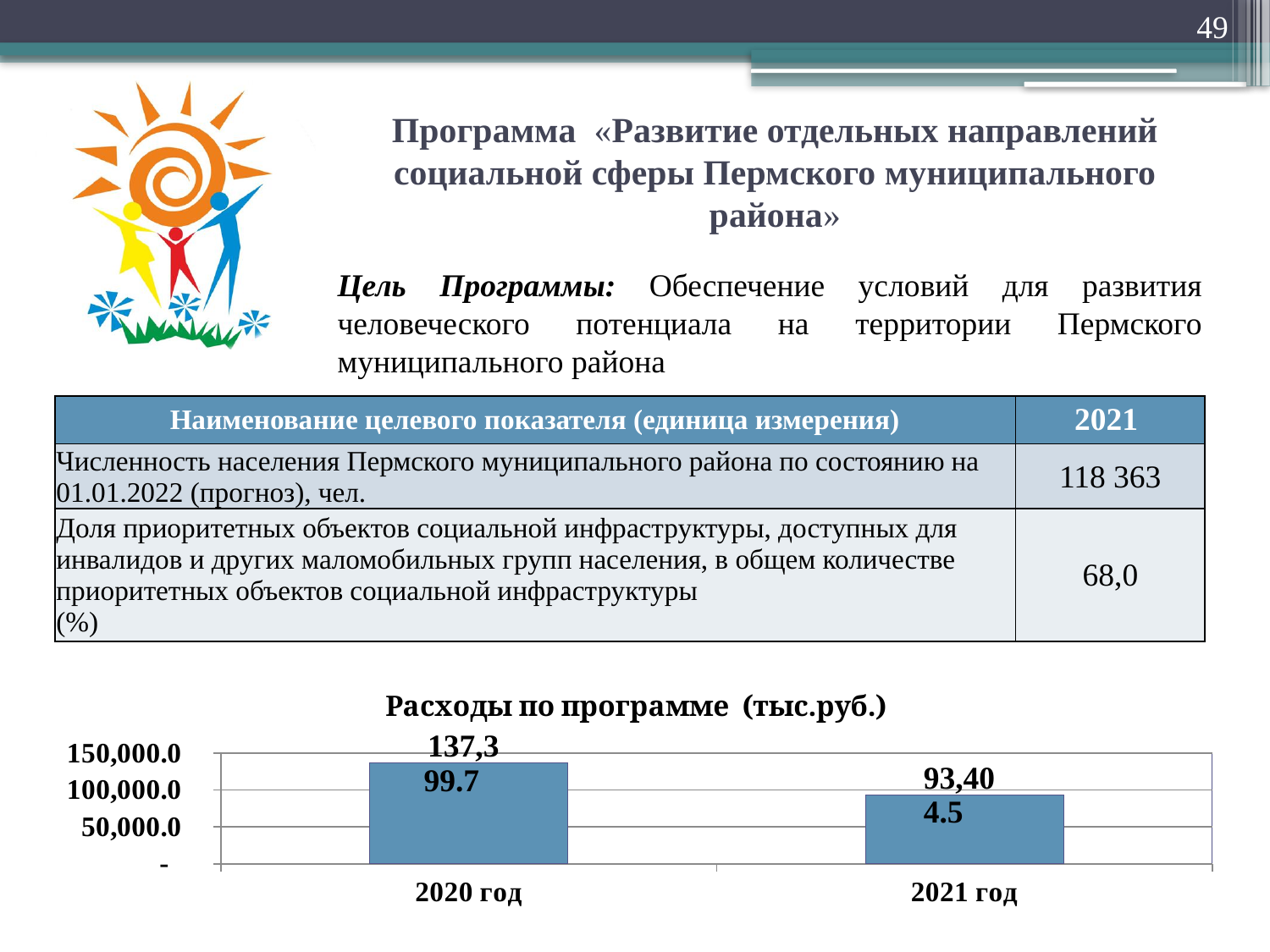
In the "Расходы по программе" chart, which year has the taller bar? 2020 год In the "Расходы по программе" chart, do the bars rise or fall from 2020 год to 2021 год? fall In the "Расходы по программе" chart, which year has the shorter bar? 2021 год In the "Расходы по программе" chart, is the bar for 2021 год greater or less than 50,000.0? greater What is the highest tick value shown on the y axis of the "Расходы по программе" chart? 150,000.0 In the "Расходы по программе" chart, is the bar for 2020 год greater or less than 100,000.0? greater In the "Расходы по программе" chart, what value is printed above the bar for 2021 год? 93,404.5 What is the title of the chart at the bottom of the slide? Расходы по программе (тыс.руб.) In the "Расходы по программе" chart, is the bar for 2021 год greater or less than 100,000.0? less How many categories are shown on the x axis of the "Расходы по программе" chart? 2 In the "Расходы по программе" chart, what value is printed above the bar for 2020 год? 137,399.7 What kind of chart is shown under the title "Расходы по программе (тыс.руб.)"? bar chart